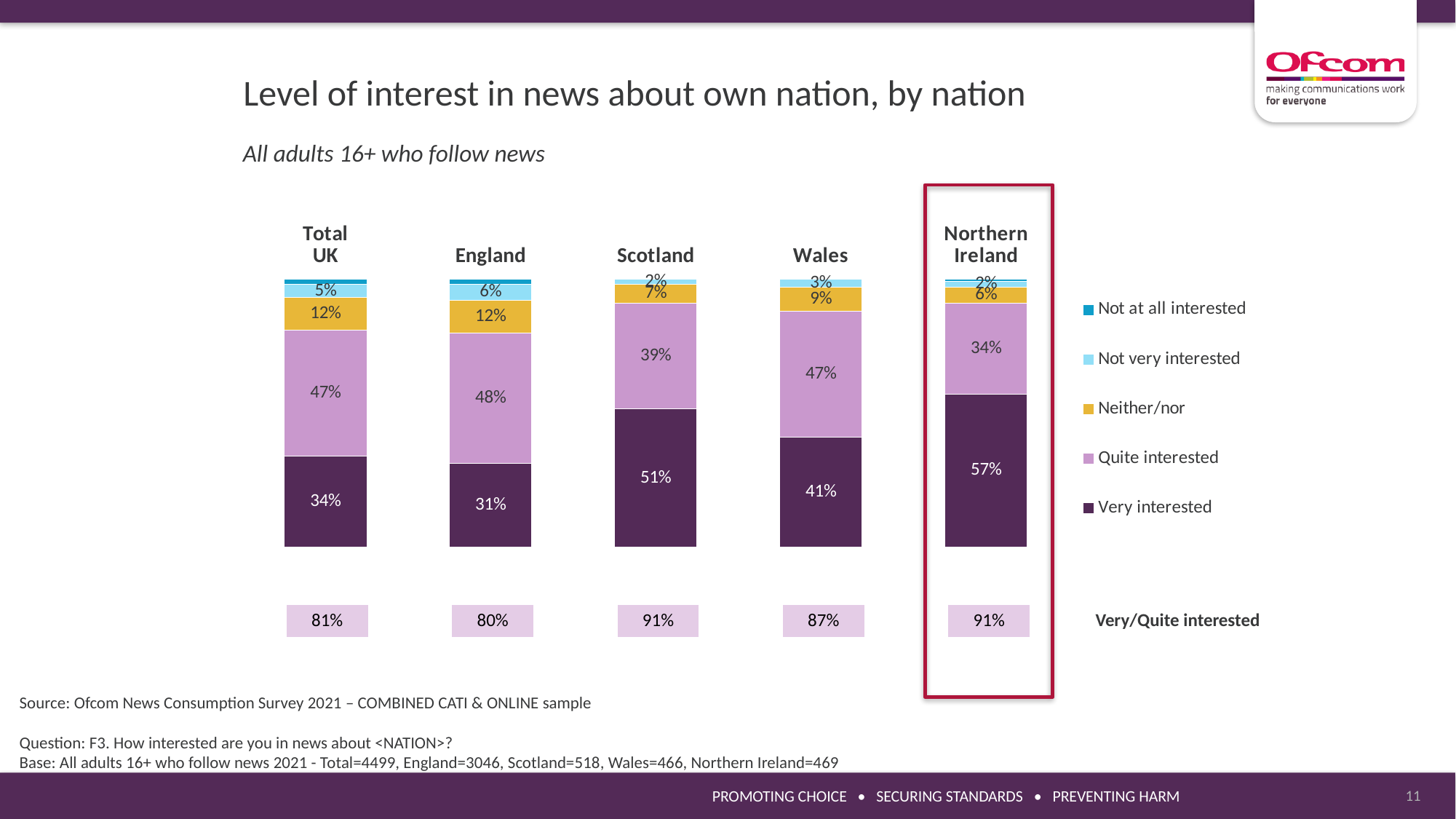
How many series does the legend list? 5 Which nation has the highest share of adults who are very interested in news about their own nation? Northern Ireland What percentage of adults in Northern Ireland are very interested in news about their own nation? 57% What is the combined Very/Quite interested figure shown for Scotland? 91% Which bar on the chart is highlighted with a red outline? Northern Ireland How many nation categories (bars) are shown in the chart? 5 What type of chart is shown on the slide? Stacked bar chart What is the difference in percentage points between the very interested share in Scotland and in Wales? 10 percentage points Which is larger: the Very/Quite interested figure for Wales or for England? Wales Which category has the lowest share of adults who are very interested in news about their own nation? England What percentage of adults in England are quite interested in news about their own nation? 48% What is the Neither/nor value for Wales? 9%